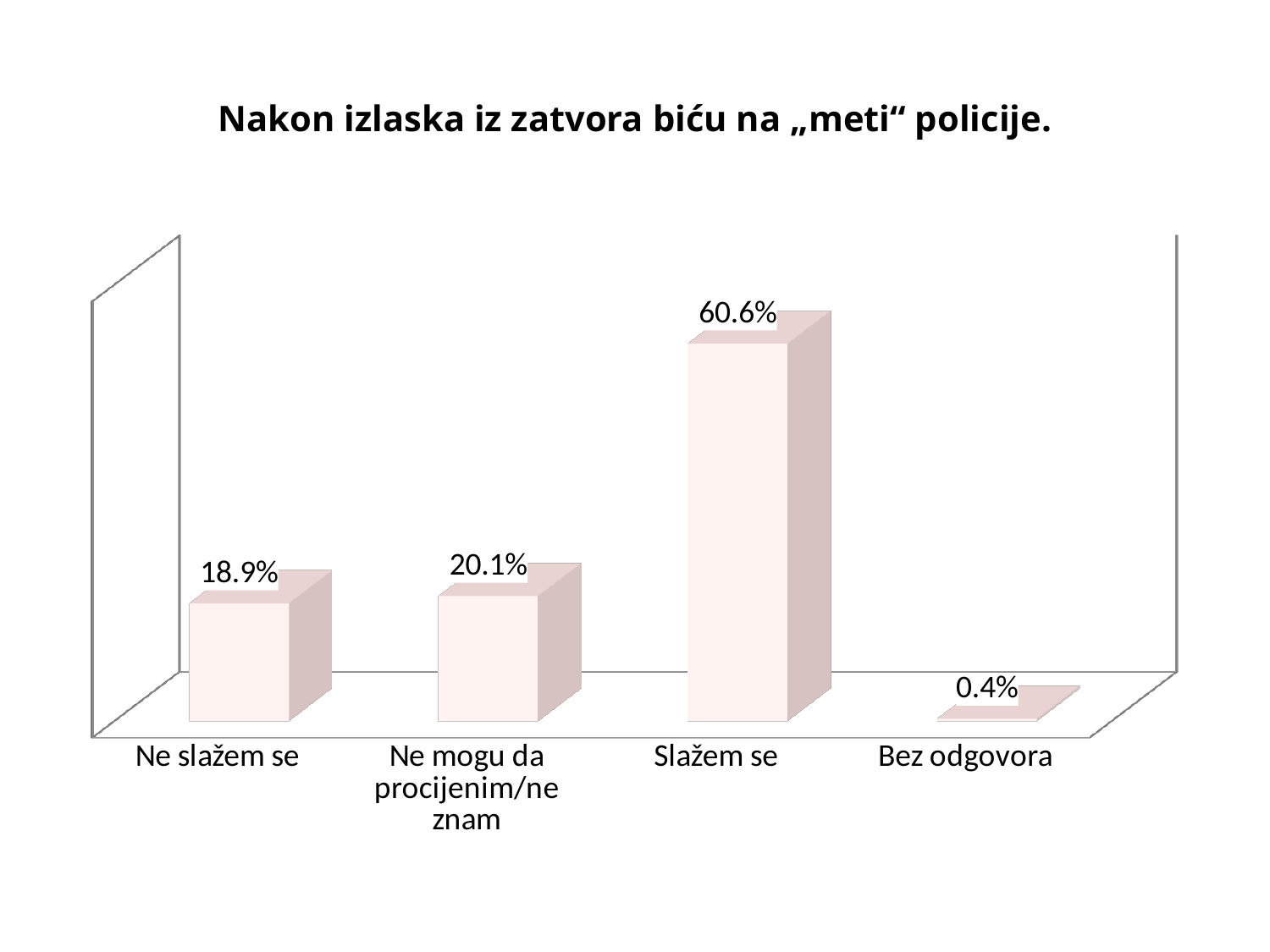
What is the difference between the values for "Slažem se" and "Ne slažem se"? 41.7% Which category has the lowest value? Bez odgovora Which category has the highest value? Slažem se What kind of chart is shown on the slide? Bar chart How many categories are shown on the chart? 4 What is the value for "Slažem se"? 60.6% What is the difference between the values for "Ne mogu da procijenim/ne znam" and "Ne slažem se"? 1.2% What is the value for "Bez odgovora"? 0.4% Which is larger, the value for "Ne slažem se" or the value for "Slažem se"? Slažem se What is the value for "Ne slažem se"? 18.9% What is the title of the chart? Nakon izlaska iz zatvora biću na „meti“ policije. What is the value for "Ne mogu da procijenim/ne znam"? 20.1%